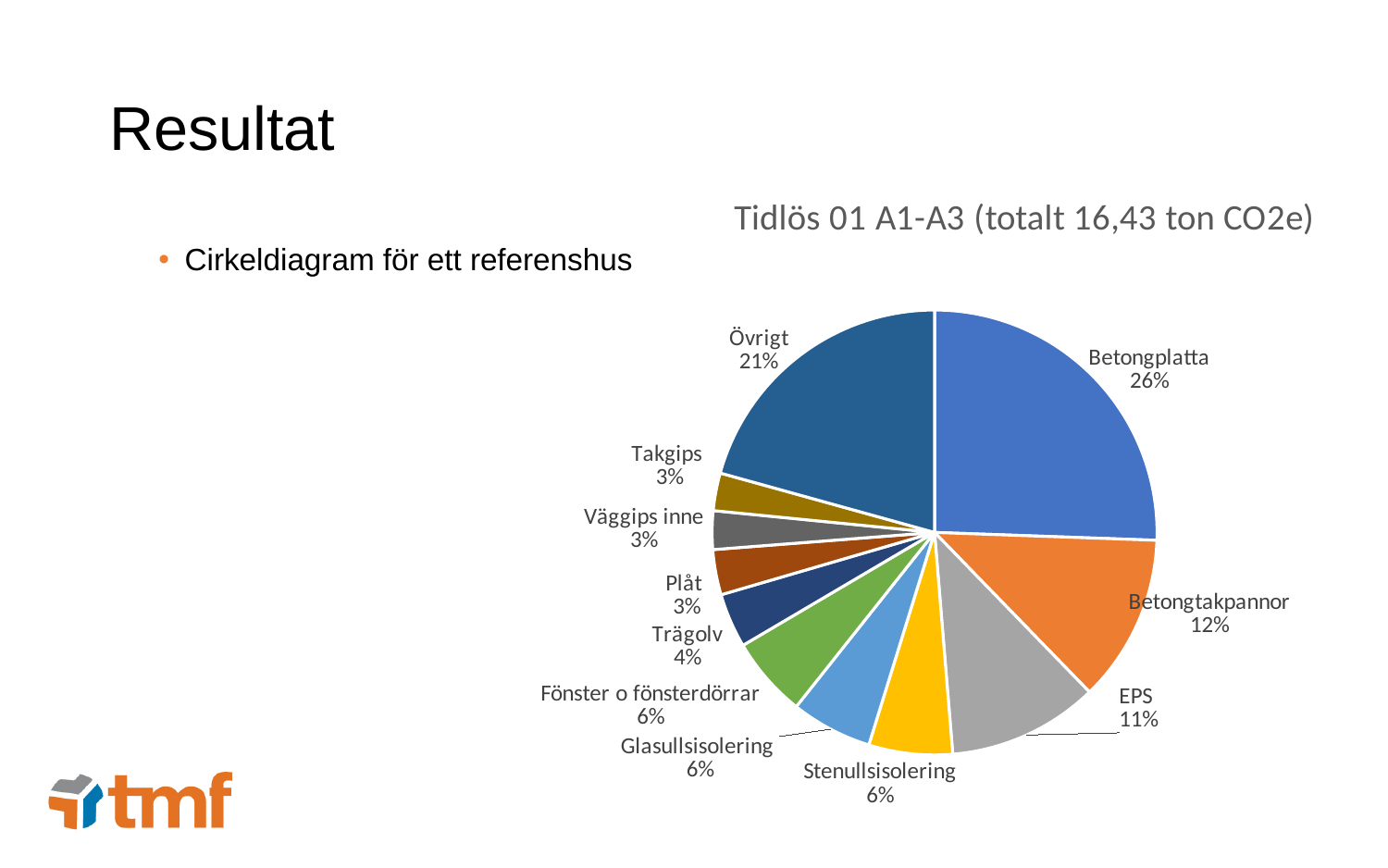
Which category has the largest slice of the pie? Betongplatta What share of the pie does Övrigt have? 21% What is the value shown for Trägolv? 4% What share of the pie does Betongplatta have? 26% How many slices does the pie chart have? 11 What is the difference in percentage points between Betongplatta and Övrigt? 5 percentage points What is the title of the pie chart? Tidlös 01 A1-A3 (totalt 16,43 ton CO2e) What is the combined share of Stenullsisolering and Glasullsisolering? 12% What is the value shown for EPS? 11% Which is larger, the slice for Betongtakpannor or the slice for Trägolv? Betongtakpannor What is the value shown for Betongtakpannor? 12% What kind of chart is shown on the slide? Pie chart